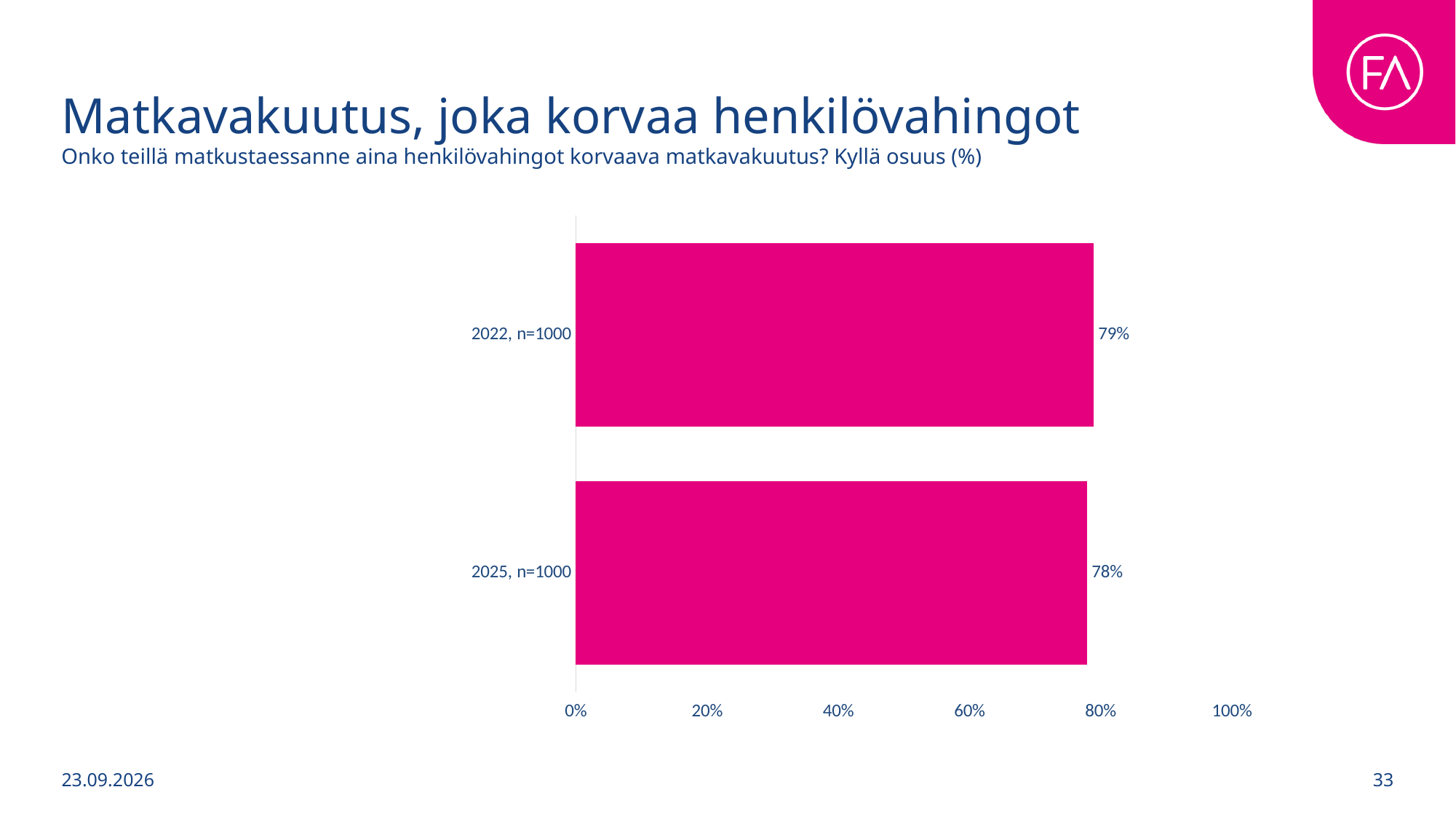
Which category has the lowest value? 2025, n=1000 Is the value for 2022, n=1000 greater or less than 100%? less What kind of chart is shown on the slide? Bar chart What is the value for 2022, n=1000? 79% How many categories are shown in the chart? 2 Do the values rise or fall from 2022 to 2025? Fall What is the title of the slide containing the chart? Matkavakuutus, joka korvaa henkilövahingot Which is larger, the value for 2022, n=1000 or the value for 2025, n=1000? 2022, n=1000 What is the value for 2025, n=1000? 78% Is the value for 2025, n=1000 greater or less than 60%? greater Which category has the highest value? 2022, n=1000 What is the difference between the values for 2022, n=1000 and 2025, n=1000? 1%